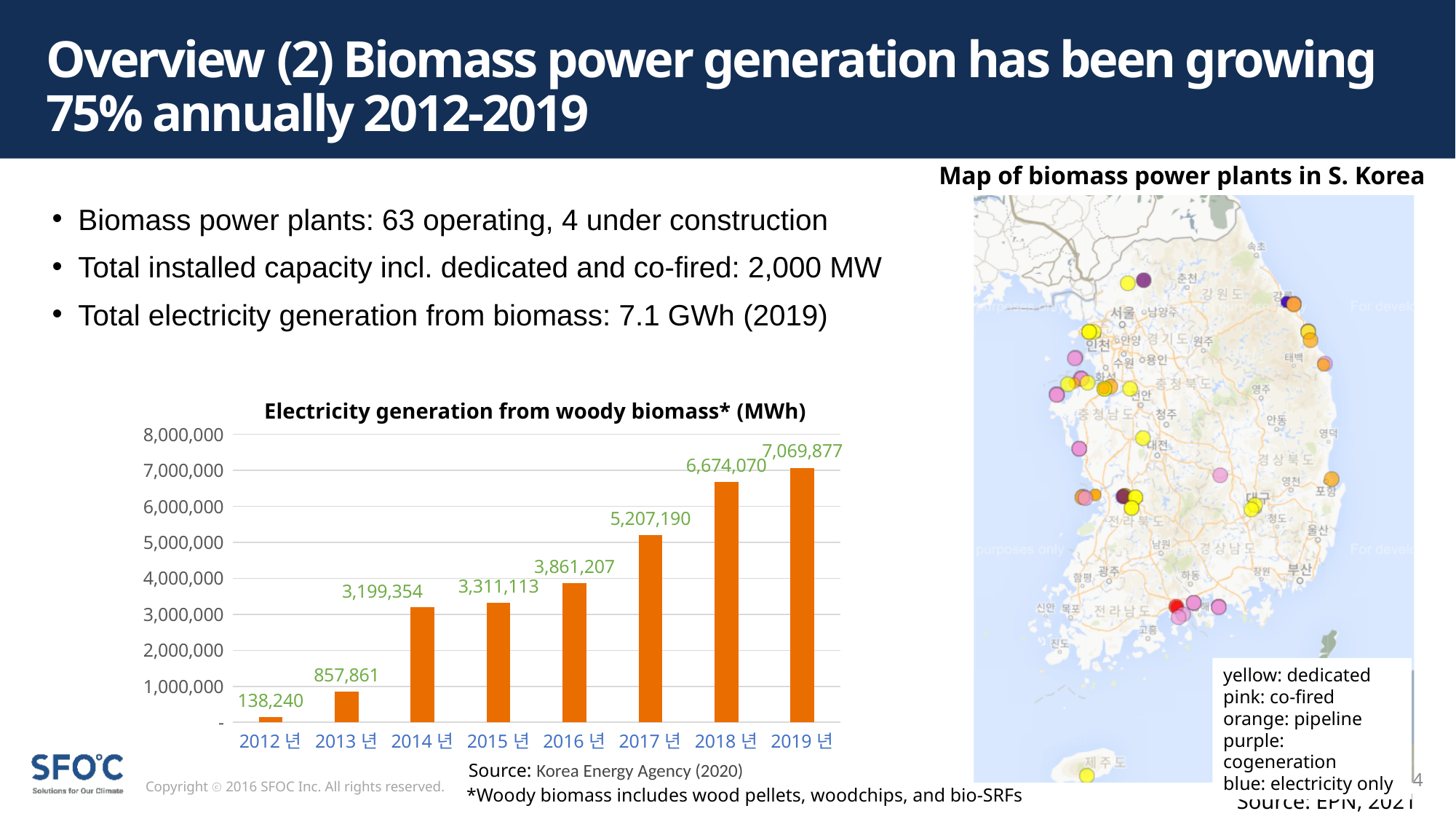
What is the difference in electricity generation from woody biomass between 2019 and 2018? 395,807 Which year has the lowest electricity generation from woody biomass? 2012 What is the electricity generation from woody biomass for 2019? 7,069,877 What is the difference in electricity generation from woody biomass between 2013 and 2012? 719,621 Which year has higher electricity generation from woody biomass, 2015 or 2014? 2015 Which year has the highest electricity generation from woody biomass? 2019 Is the electricity generation from woody biomass for 2017 greater or less than 5,000,000? greater What is the electricity generation from woody biomass for 2016? 3,861,207 Does electricity generation from woody biomass rise or fall from 2012 to 2019? rise How many years are shown in the electricity generation from woody biomass chart? 8 What is the electricity generation from woody biomass for 2012? 138,240 What kind of chart is used to show electricity generation from woody biomass? bar chart